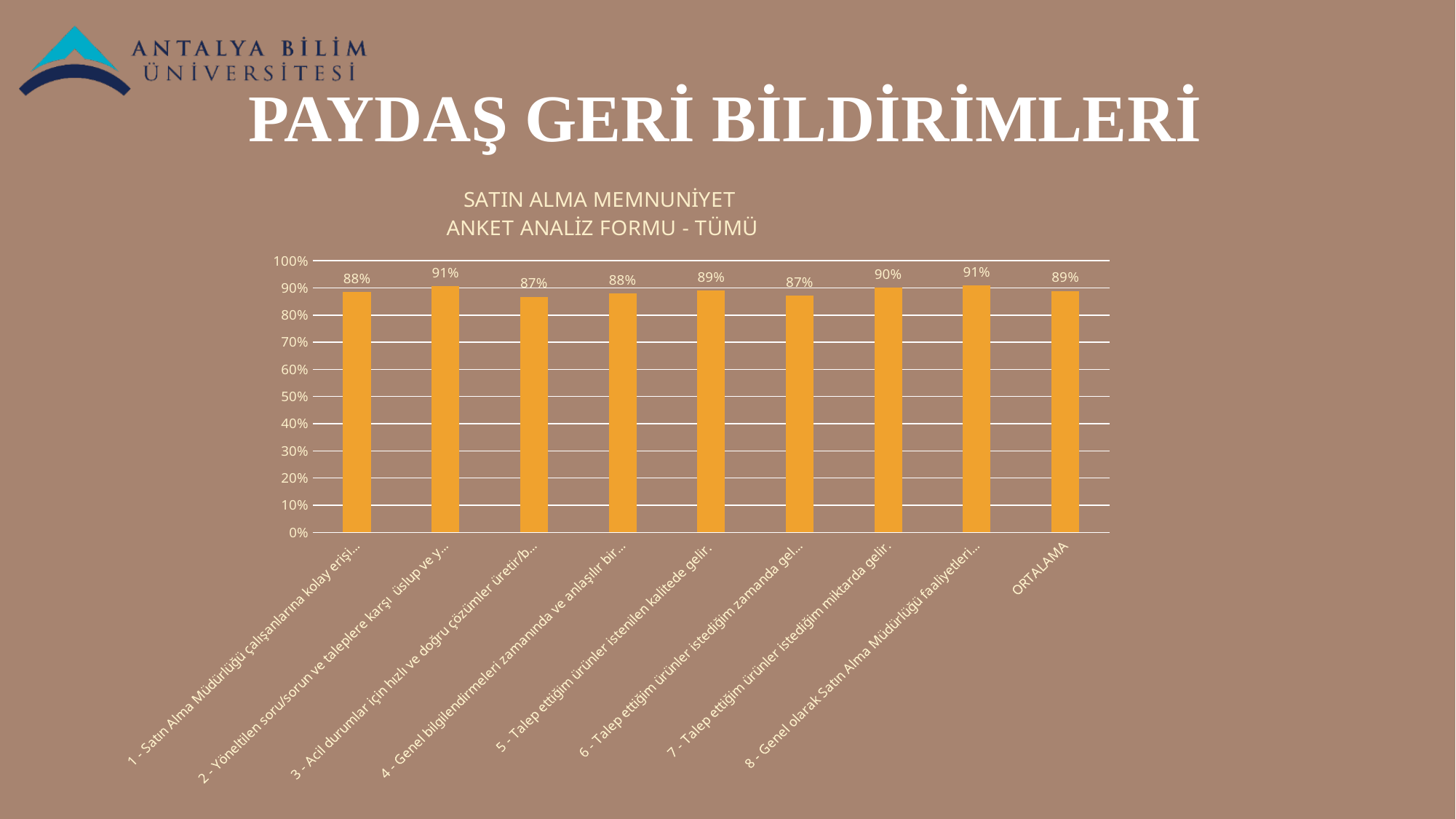
What is the value for item 7, 'Talep ettiğim ürünler istediğim miktarda gelir.'? 90% What is the value for item 3, 'Acil durumlar için hızlı ve doğru çözümler üretir...'? 87% Which is larger: the value for item 7 or the value for item 6? item 7 What is the value for item 5, 'Talep ettiğim ürünler istenilen kalitede gelir.'? 89% What is the lowest value shown in the chart? 87% What is the value of the ORTALAMA bar? 89% How many bars are plotted in the chart? 9 What is the title of the chart? SATIN ALMA MEMNUNİYET ANKET ANALİZ FORMU - TÜMÜ What is the difference between the value for item 2 (91%) and the value for item 3 (87%)? 4% What is the highest value shown in the chart? 91% Is the value for item 1 greater or less than 80%? greater What type of chart is shown on the slide? bar chart